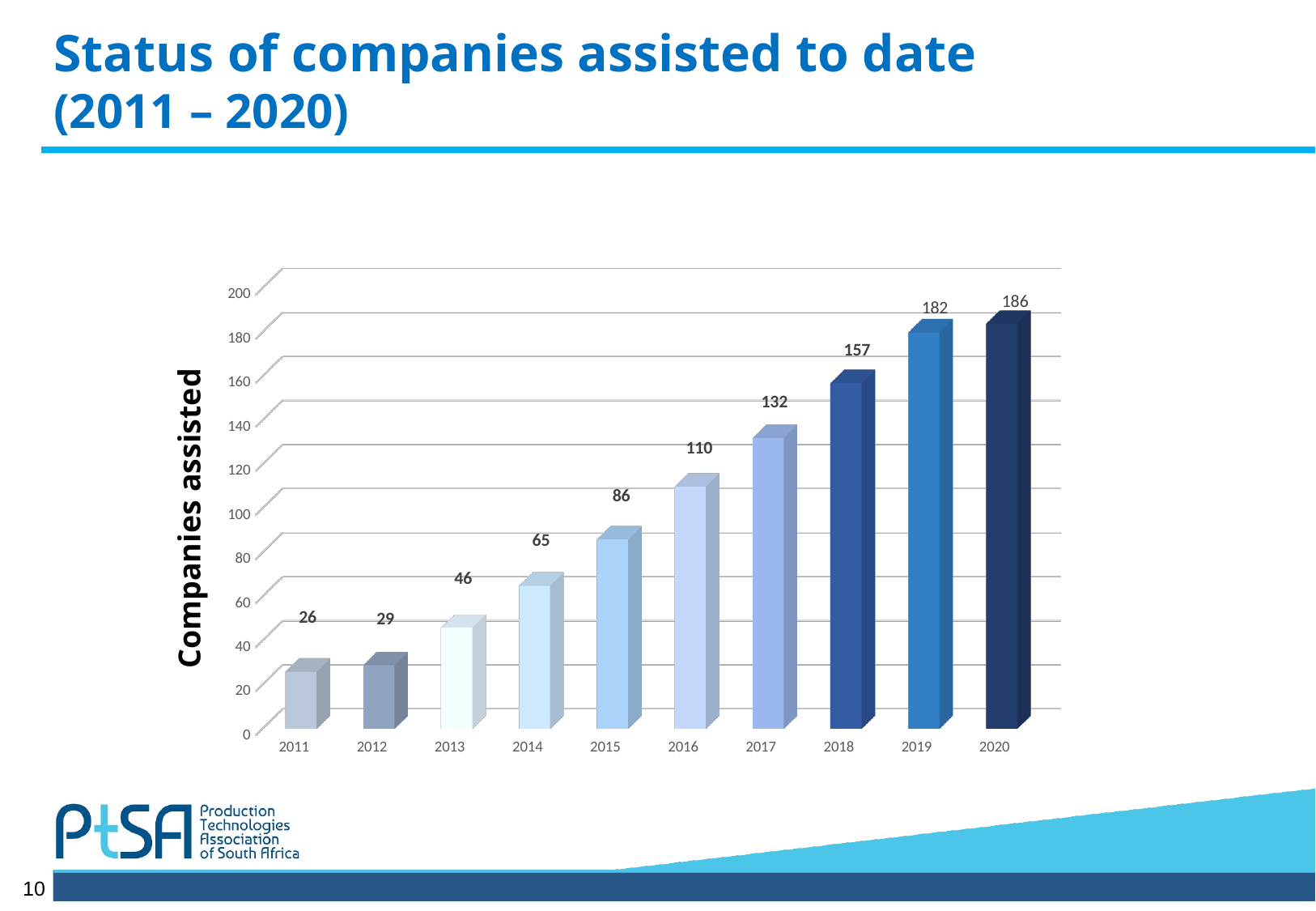
Do the values rise or fall from 2011 to 2020? Rise Which year has the lowest number of companies assisted? 2011 What is the value shown for 2018? 157 What is the difference between the values for 2014 and 2013? 19 How many companies were assisted in 2015? 86 What kind of chart is shown on the slide? Bar chart What is the difference between the values for 2019 and 2017? 50 Which year has the highest number of companies assisted? 2020 Is the value for 2016 greater or less than 100? greater How many years are shown on the x axis? 10 What is the value shown for 2011? 26 Which year has a larger value, 2016 or 2017? 2017